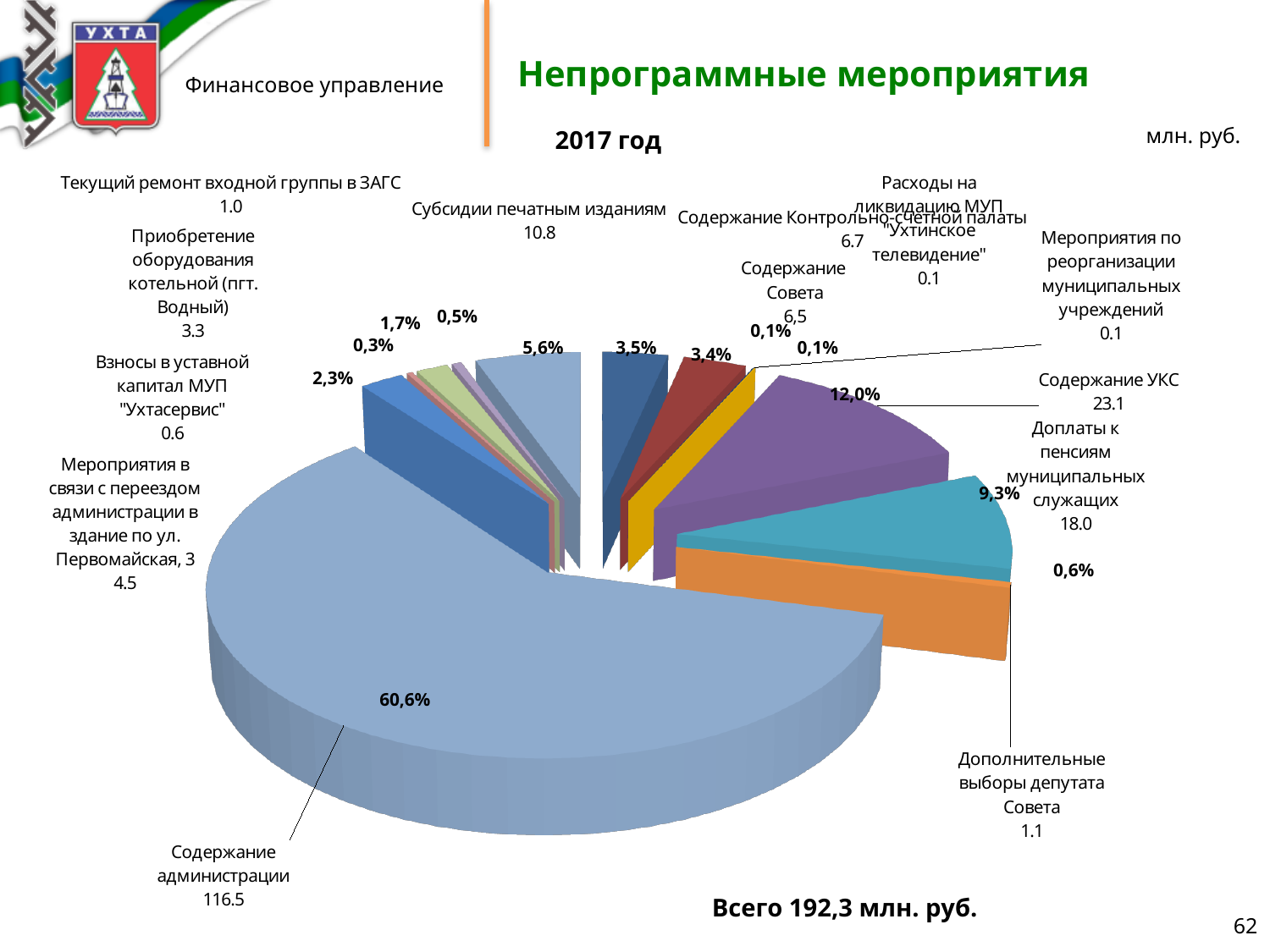
What year does the chart refer to? 2017 год Which is larger: Содержание Контрольно-счетной палаты or Содержание Совета? Содержание Контрольно-счетной палаты What is the difference between Содержание УКС and Доплаты к пенсиям муниципальных служащих? 5.1 How many categories are shown in the pie chart? 13 What is the value for Содержание администрации? 116.5 What share of the pie does Содержание администрации represent? 60,6% Which category has the highest value? Содержание администрации What is the value for Доплаты к пенсиям муниципальных служащих? 18.0 What is the value for Субсидии печатным изданиям? 10.8 What is the total shown for all categories? 192,3 млн. руб. What is the value for Содержание УКС? 23.1 What kind of chart is shown on the slide? Pie chart